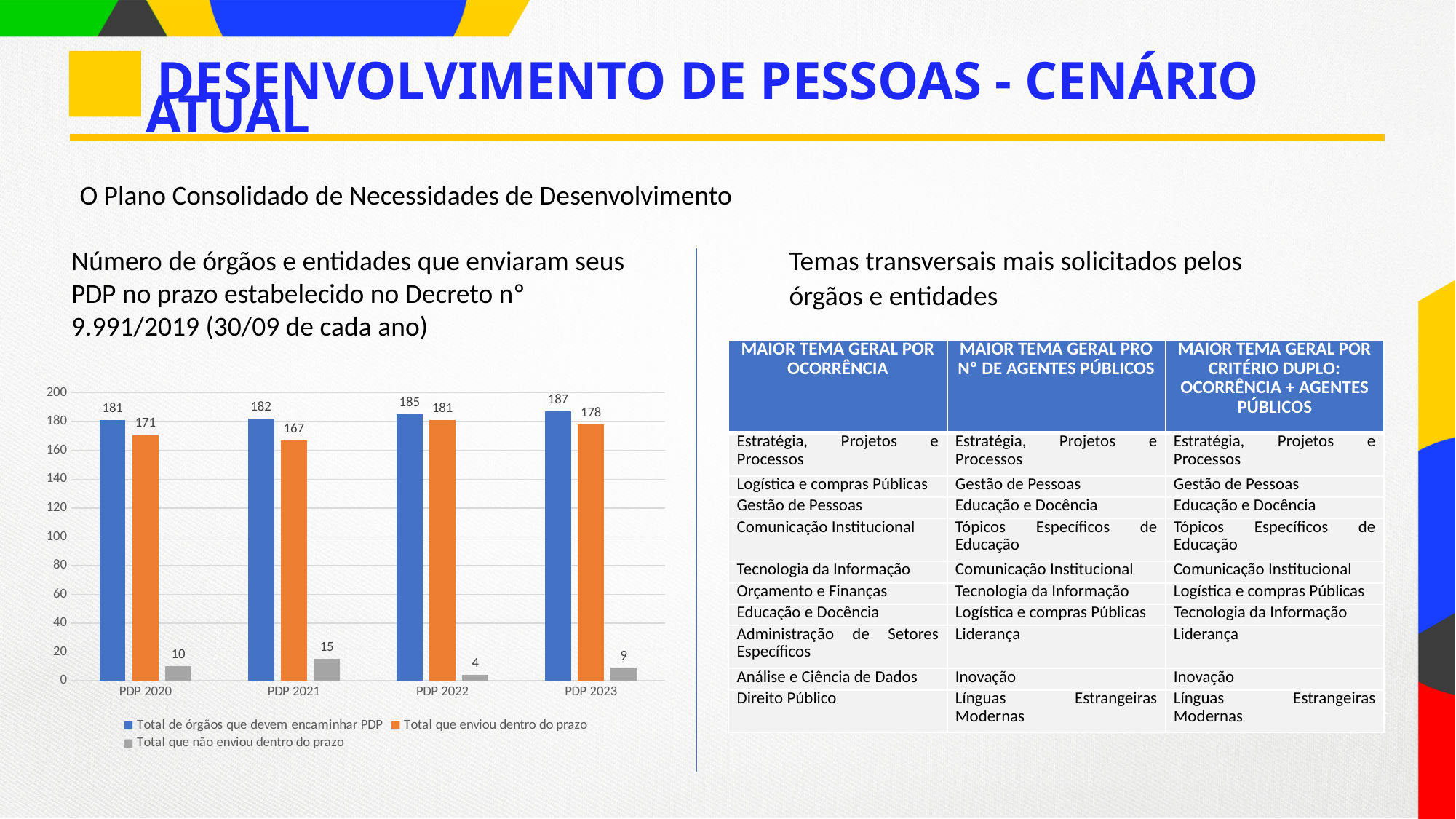
What is the value of "Total de órgãos que devem encaminhar PDP" for PDP 2020? 181 Which is larger: "Total que enviou dentro do prazo" for PDP 2020 or for PDP 2023? PDP 2023 What is the value of "Total que enviou dentro do prazo" for PDP 2021? 167 How many categories (years) are shown on the x axis of the chart? 4 What kind of chart is shown on the slide? Bar chart What is the difference between "Total de órgãos que devem encaminhar PDP" and "Total que enviou dentro do prazo" for PDP 2022? 4 How many series does the chart legend list? 3 What is the value of "Total que enviou dentro do prazo" for PDP 2023? 178 Is the value of "Total que enviou dentro do prazo" for PDP 2021 greater or less than 180? less Which year has the lowest value for "Total que enviou dentro do prazo"? PDP 2021 Which year has the highest value for "Total que não enviou dentro do prazo"? PDP 2021 What is the value of "Total que não enviou dentro do prazo" for PDP 2022? 4